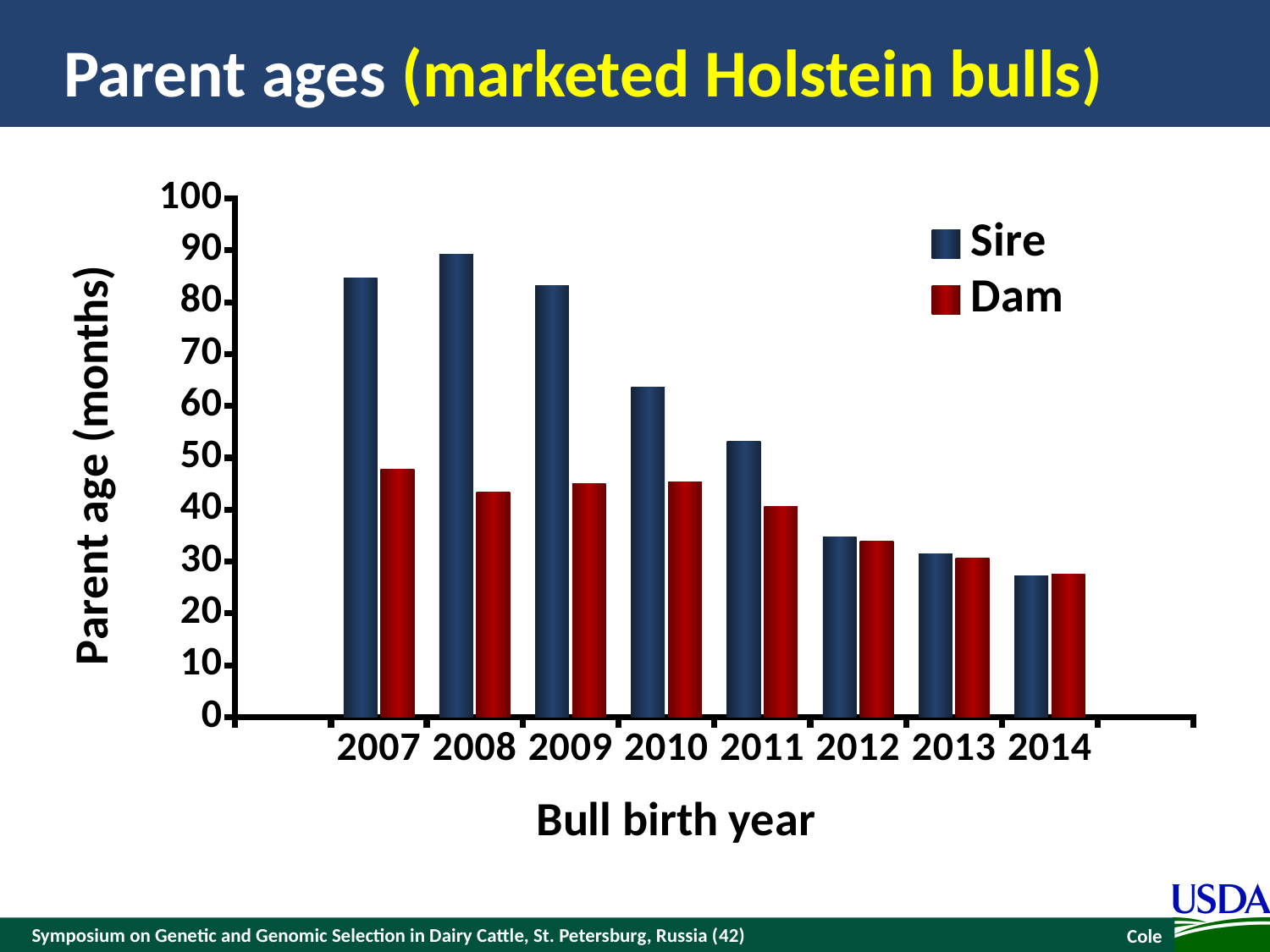
Which bull birth year has the lowest Sire parent age? 2014 Do the Sire parent ages rise or fall from 2007 to 2014? fall Is the Sire value for 2010 greater or less than 60? greater Is the Dam value for 2007 greater or less than 50? less How many bull birth years are shown on the x axis? 8 For bull birth year 2007, which is larger, the Sire or the Dam parent age? Sire Which bull birth year has the highest Dam parent age? 2007 Which bull birth year has the highest Sire parent age? 2008 What kind of chart is shown on the slide? bar chart Is the Sire value for 2014 greater or less than 30? less How many series does the legend list? 2